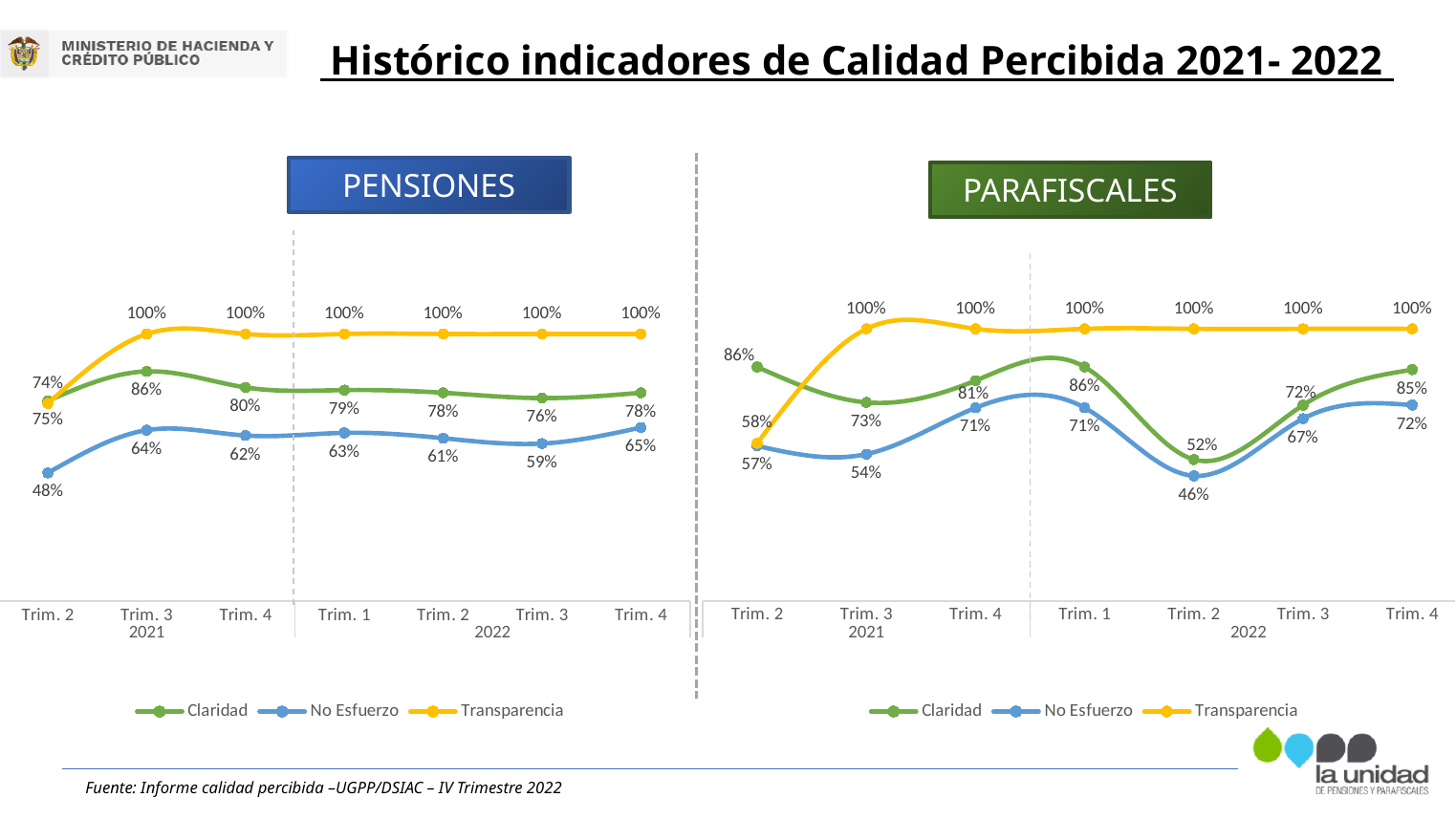
In the PARAFISCALES chart, what is the difference between Claridad and No Esfuerzo in Trim. 4 of 2021? 10% How many series does the legend of the PENSIONES chart list? 3 In the PENSIONES chart, what is the No Esfuerzo value for Trim. 4 of 2022? 65% In the PARAFISCALES chart, is Claridad in Trim. 4 of 2022 higher or lower than Claridad in Trim. 3 of 2022? higher In the PARAFISCALES chart, which quarter has the lowest No Esfuerzo value? Trim. 2 2022 In the PENSIONES chart, which quarter has the lowest No Esfuerzo value? Trim. 2 2021 In the PENSIONES chart, what is the difference between Claridad and No Esfuerzo in Trim. 3 of 2022? 17% What type of chart is the PARAFISCALES chart? Line chart In the PENSIONES chart, what is the No Esfuerzo value for Trim. 2 of 2021? 48% In the PARAFISCALES chart, what is the No Esfuerzo value for Trim. 3 of 2021? 54% In the PARAFISCALES chart, what is the Claridad value for Trim. 2 of 2022? 52% In the PENSIONES chart, what is the Claridad value for Trim. 3 of 2021? 86%